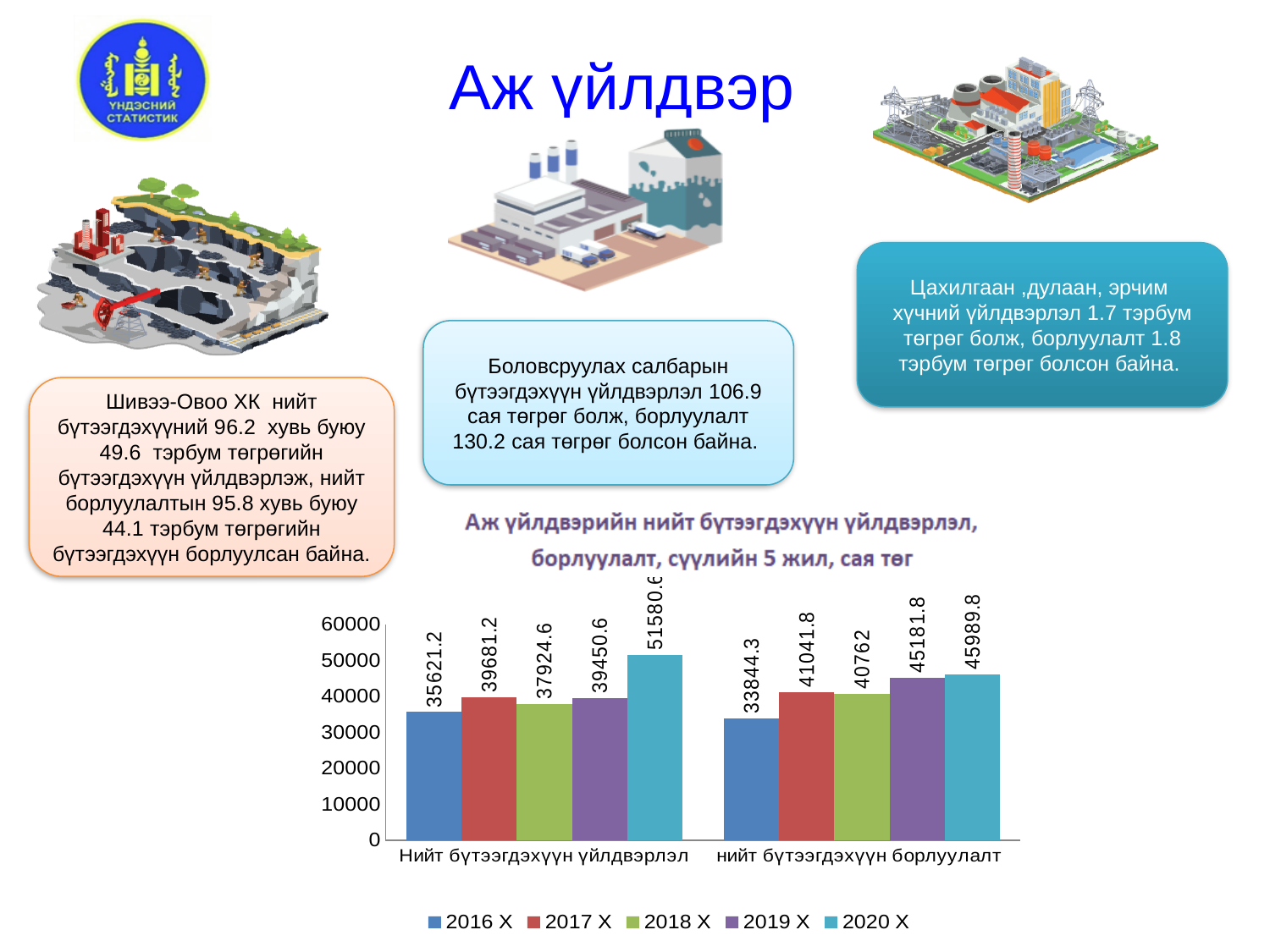
What is the difference between the 2017 X and 2016 X values in the Нийт бүтээгдэхүүн үйлдвэрлэл category? 4060 What is the value for 2019 X in the нийт бүтээгдэхүүн борлуулалт category? 45181.8 Which is larger in the нийт бүтээгдэхүүн борлуулалт category: the 2017 X value or the 2018 X value? 2017 X What type of chart is shown on the slide? bar chart Is the 2020 X value in the нийт бүтээгдэхүүн борлуулалт category greater or less than 40000? greater Which year has the lowest value in the нийт бүтээгдэхүүн борлуулалт category? 2016 X What is the value for 2016 X in the Нийт бүтээгдэхүүн үйлдвэрлэл category? 35621.2 What unit is stated in the chart title? сая төг Which year has the highest value in the Нийт бүтээгдэхүүн үйлдвэрлэл category? 2020 X How many series does the chart legend list? 5 How many categories are shown on the x axis of the chart? 2 What is the value for 2018 X in the нийт бүтээгдэхүүн борлуулалт category? 40762